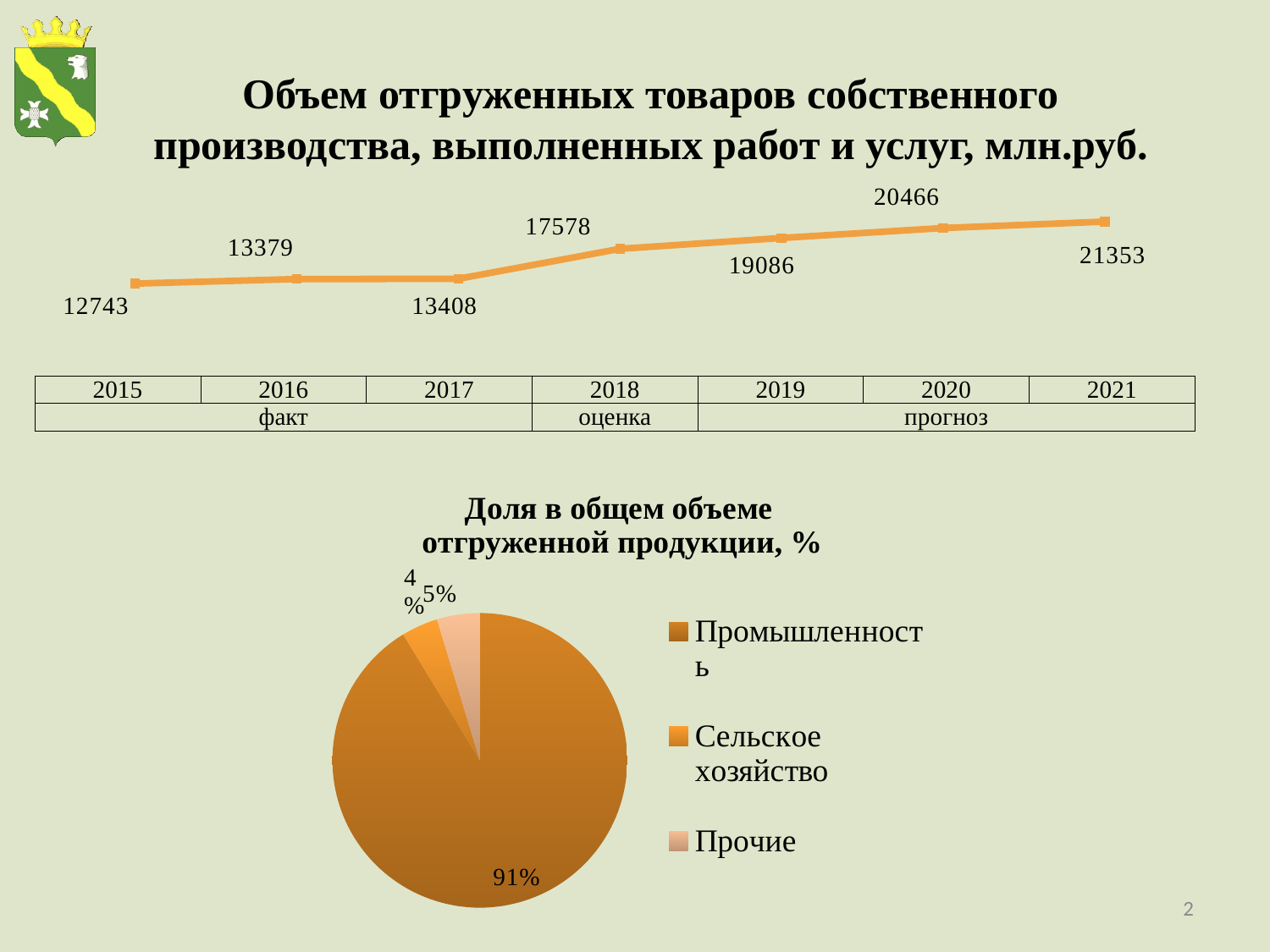
On the top line chart, which year has the highest value? 2021 On the top line chart, what is the value for 2015? 12743 On the top line chart, what is the value for 2021? 21353 On the top line chart, how many data points are plotted? 7 On the pie chart 'Доля в общем объеме отгруженной продукции, %', how many categories does the legend list? 3 On the top line chart, what is the difference between the values for 2018 and 2017? 4170 What kind of chart is the top chart on the slide? line chart On the top line chart, what is the value for 2018? 17578 On the top line chart, what is the difference between the values for 2021 and 2015? 8610 On the top line chart, which year has the lowest value? 2015 On the top line chart, do the values rise or fall from 2015 to 2021? rise On the pie chart 'Доля в общем объеме отгруженной продукции, %', what share does Промышленность have? 91%